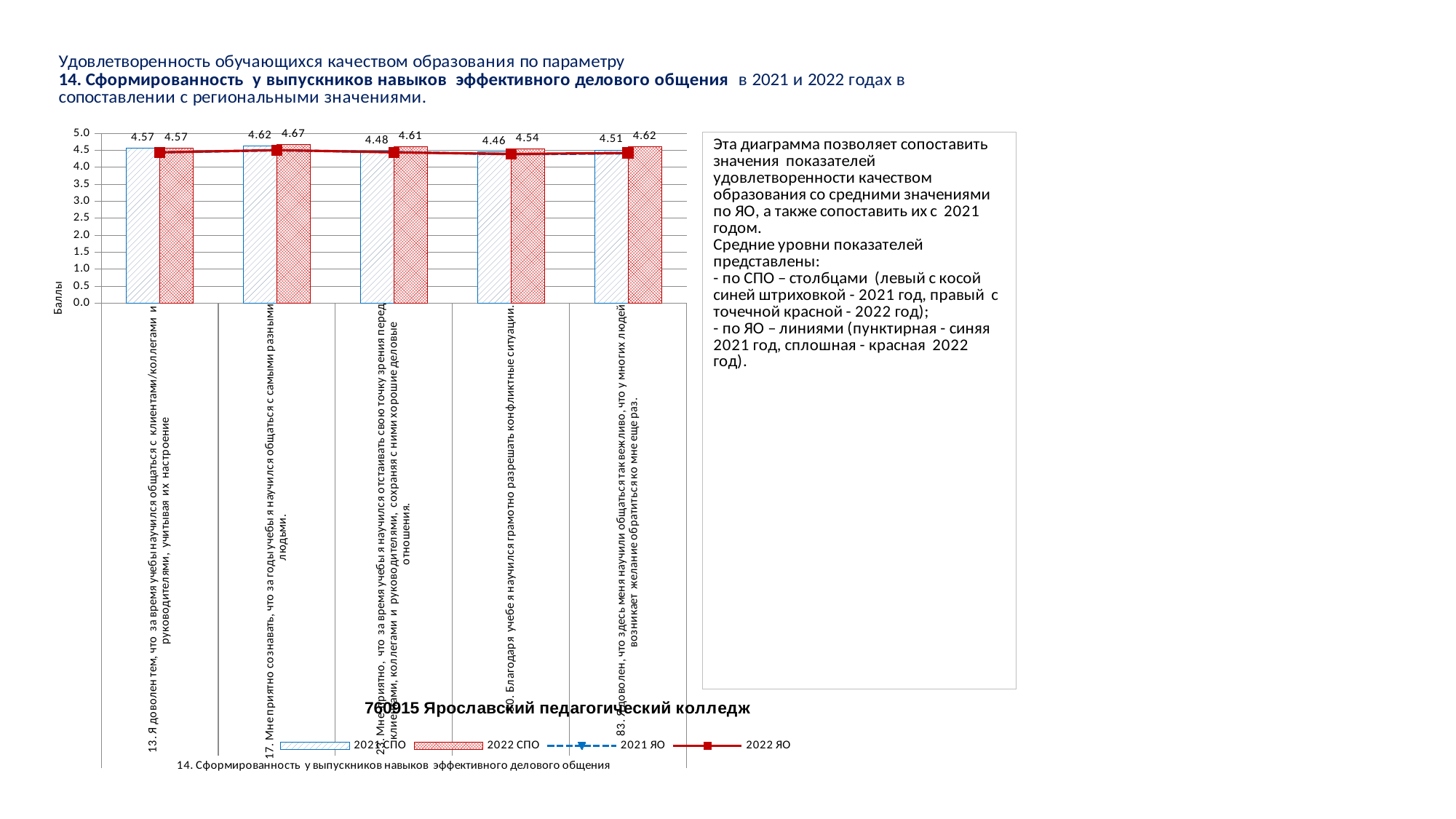
What is the 2022 СПО value for category 17 ("Мне приятно сознавать, что за годы учебы я научился общаться с самыми разными людьми")? 4.67 How many categories (questions) are shown on the x axis of the chart? 5 For category 83, which is larger: the 2021 СПО value or the 2022 СПО value? 2022 СПО What is the label of the vertical axis of the chart? Баллы What kind of chart is shown on the slide? Combined bar and line chart How many series does the chart legend list? 4 Which category has the highest 2022 СПО value? 17. Мне приятно сознавать, что за годы учебы я научился общаться с самыми разными людьми What is the difference between the 2022 СПО and 2021 СПО values for category 23? 0.13 What is the 2021 СПО value for category 13 ("Я доволен тем, что за время учебы научился общаться с клиентами/коллегами и руководителями, учитывая их настроение")? 4.57